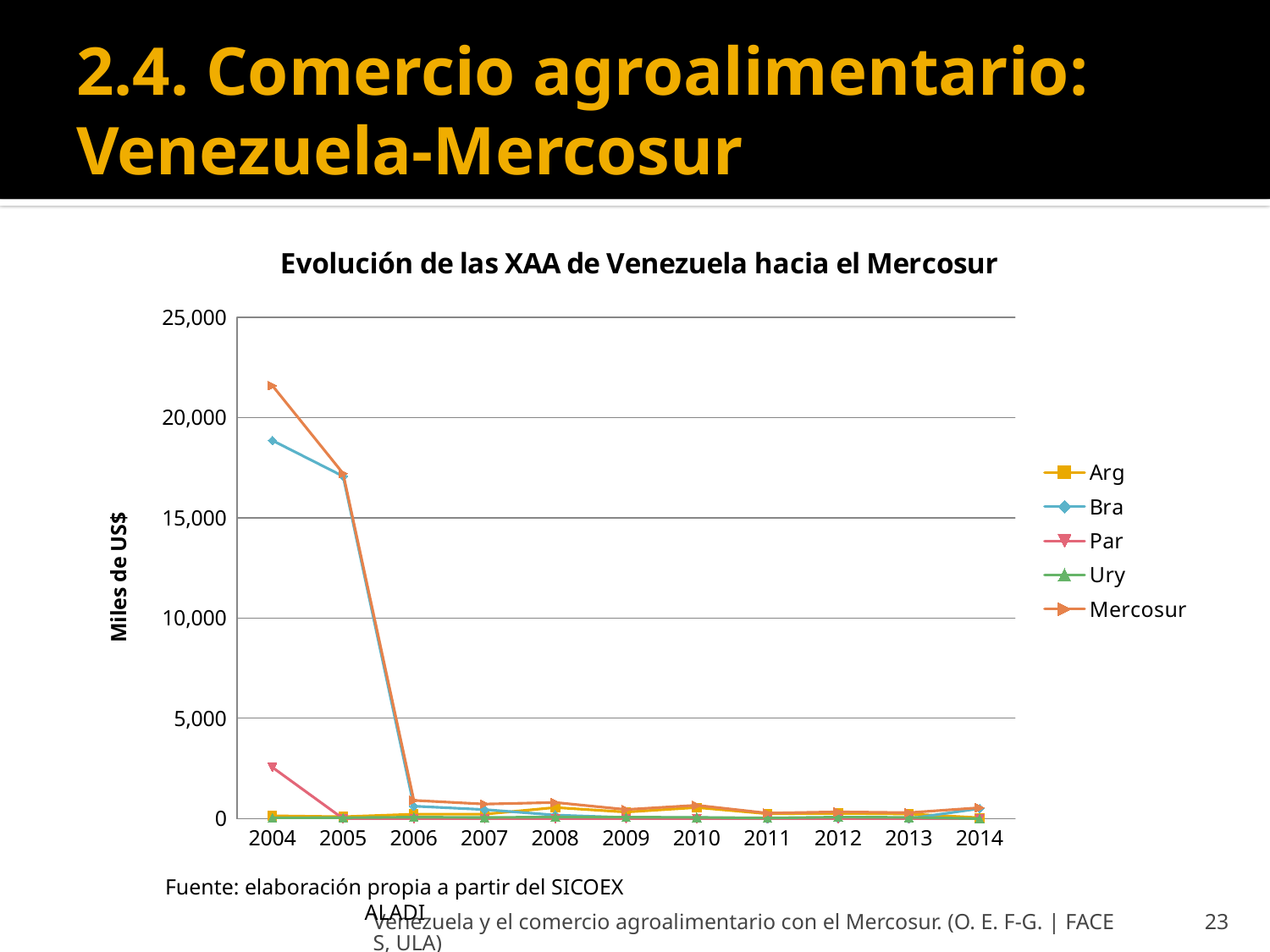
What is the label on the vertical axis? Miles de US$ In which year does the Mercosur series reach its highest value? 2004 Is the value for Mercosur in 2005 greater or less than 15,000? greater Is the value for Bra in 2004 greater or less than 20,000? less Is the value for Par in 2004 greater or less than 5,000? less What kind of chart is shown on the slide? line chart Do the values for the Mercosur series generally rise or fall from 2004 to 2014? fall How many series does the legend list? 5 How many years are plotted along the x axis? 11 Which is larger for Mercosur: the value in 2004 or the value in 2006? 2004 What is the title of the chart? Evolución de las XAA de Venezuela hacia el Mercosur